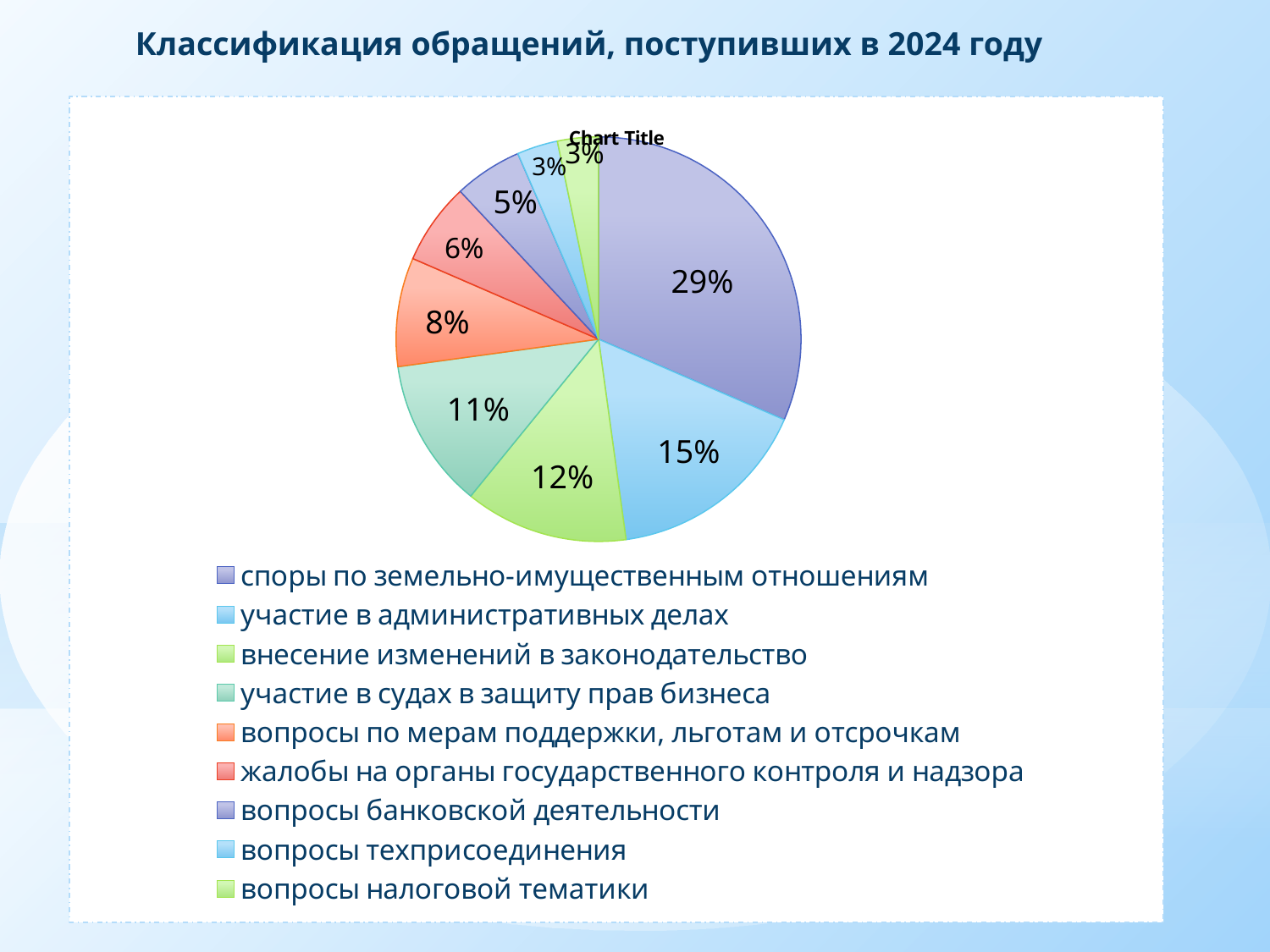
What kind of chart is shown on the slide? pie chart What share of the pie is labelled for "участие в административных делах"? 15% What share of the pie is labelled for "вопросы по мерам поддержки, льготам и отсрочкам"? 8% How many slices does the pie chart have? 9 What share of the pie is labelled for "жалобы на органы государственного контроля и надзора"? 6% Which category has the largest slice of the pie? споры по земельно-имущественным отношениям What is the difference in percentage points between the slice for "споры по земельно-имущественным отношениям" and the slice for "участие в административных делах"? 14 Which slice is larger: "участие в судах в защиту прав бизнеса" or "вопросы по мерам поддержки, льготам и отсрочкам"? участие в судах в защиту прав бизнеса